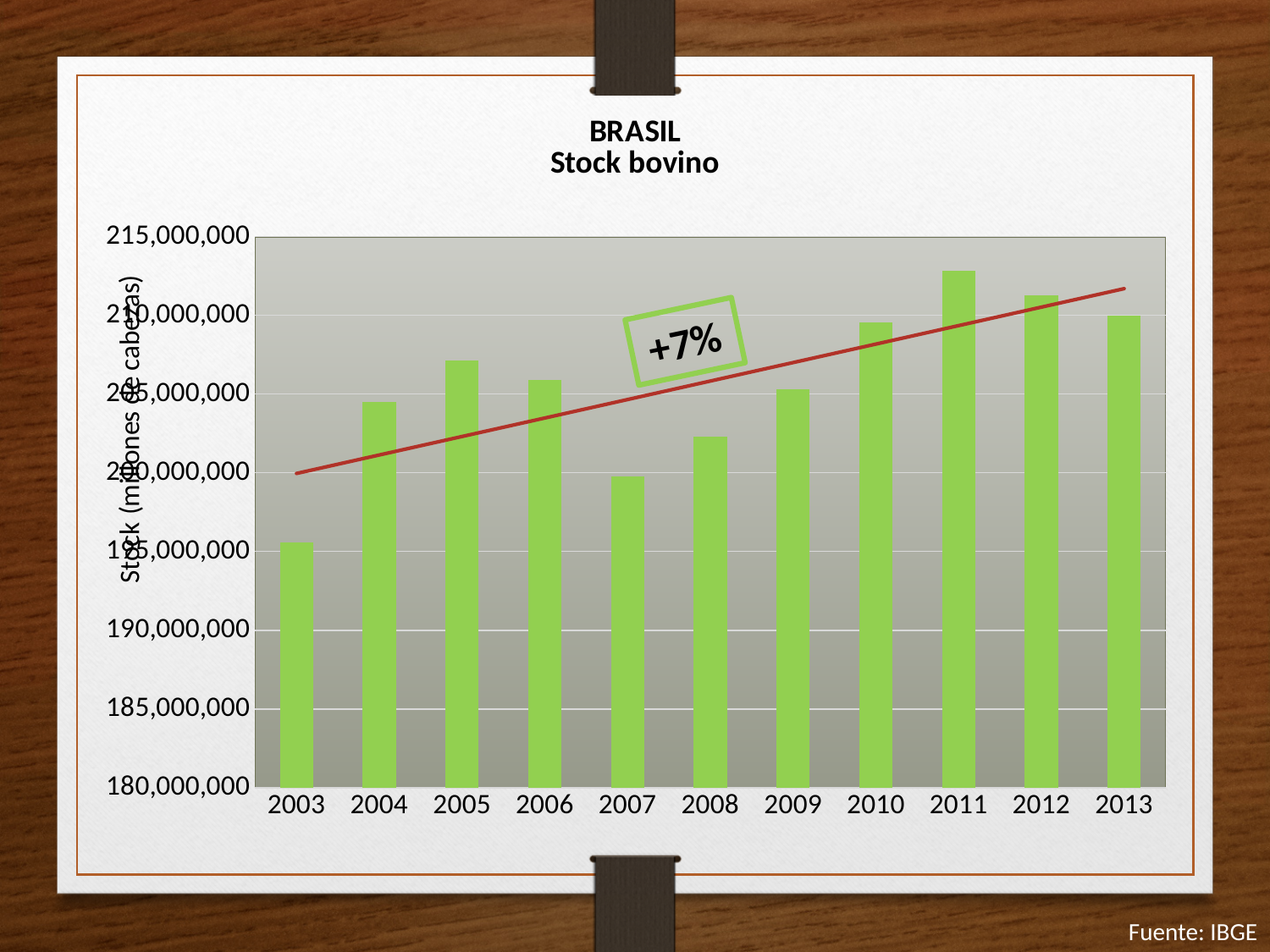
What percentage change is annotated on the trend line? +7% Is the value for 2011 greater or less than 210,000,000? greater Which year has the lowest stock bovino value? 2003 What kind of chart is shown on the slide? bar chart Do the values generally rise or fall from 2003 to 2013? rise How many years are shown on the x axis? 11 Is the value for 2005 greater or less than 205,000,000? greater Is the value for 2003 greater or less than 200,000,000? less Which year has the larger value, 2008 or 2010? 2010 Which year has the larger value, 2005 or 2007? 2005 Which year has the highest stock bovino value? 2011